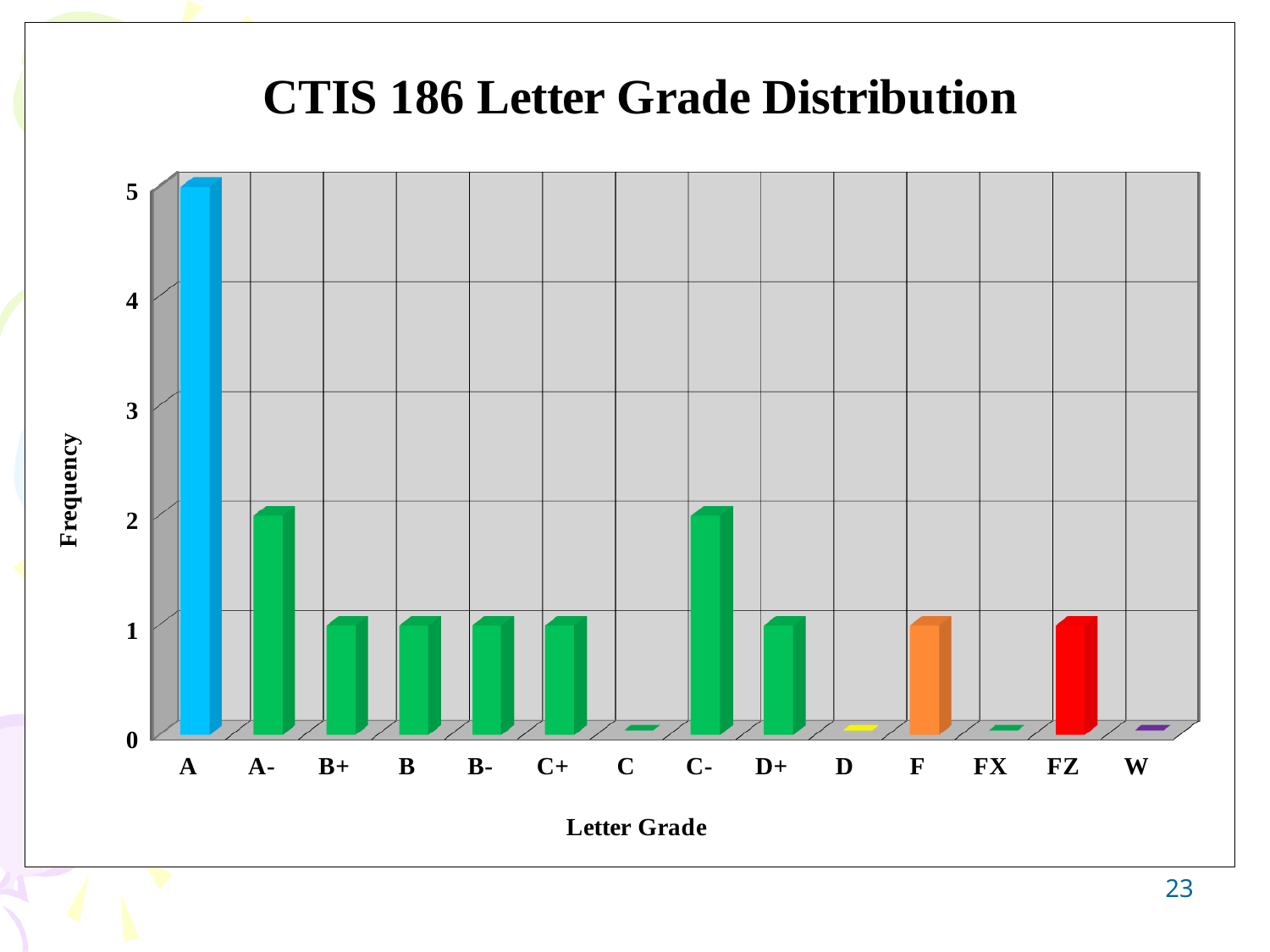
What is the frequency for letter grade A? 5 What is the frequency for letter grade A-? 2 What is the frequency for letter grade FZ? 1 Which has a higher frequency, letter grade C- or letter grade D+? C- How many letter grade categories are shown on the x axis? 14 What is the frequency for letter grade C-? 2 What is the frequency for letter grade C? 0 Which letter grade has the highest frequency? A What is the label of the y axis? Frequency What is the title of the chart? CTIS 186 Letter Grade Distribution What kind of chart is shown on the slide? bar chart What is the difference in frequency between letter grade A and letter grade A-? 3